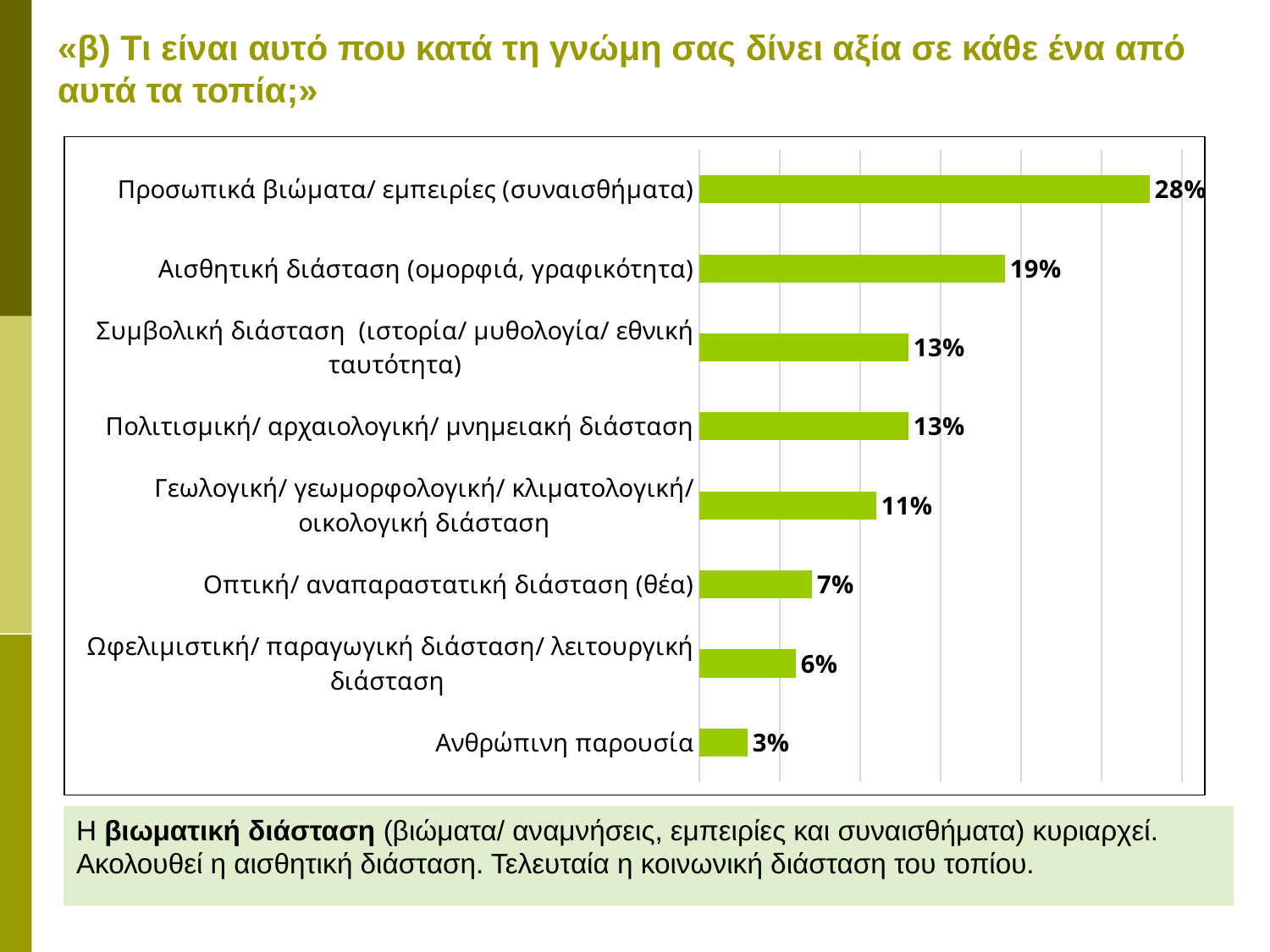
What is the value for Προσωπικά βιώματα/ εμπειρίες (συναισθήματα)? 28% What colour are the bars in the chart? Green How many categories are shown in the chart? 8 What is the value for Αισθητική διάσταση (ομορφιά, γραφικότητα)? 19% What is the value for Ωφελιμιστική/ παραγωγική διάσταση/ λειτουργική διάσταση? 6% Which category has the highest value? Προσωπικά βιώματα/ εμπειρίες (συναισθήματα) What is the value for Γεωλογική/ γεωμορφολογική/ κλιματολογική/ οικολογική διάσταση? 11% Which is larger, the value for Πολιτισμική/ αρχαιολογική/ μνημειακή διάσταση or the value for Οπτική/ αναπαραστατική διάσταση (θέα)? Πολιτισμική/ αρχαιολογική/ μνημειακή διάσταση What kind of chart is shown on the slide? Bar chart What is the difference between the values for Προσωπικά βιώματα/ εμπειρίες (συναισθήματα) and Αισθητική διάσταση (ομορφιά, γραφικότητα)? 9% Which category has the lowest value? Ανθρώπινη παρουσία What is the difference between the values for Οπτική/ αναπαραστατική διάσταση (θέα) and Ανθρώπινη παρουσία? 4%